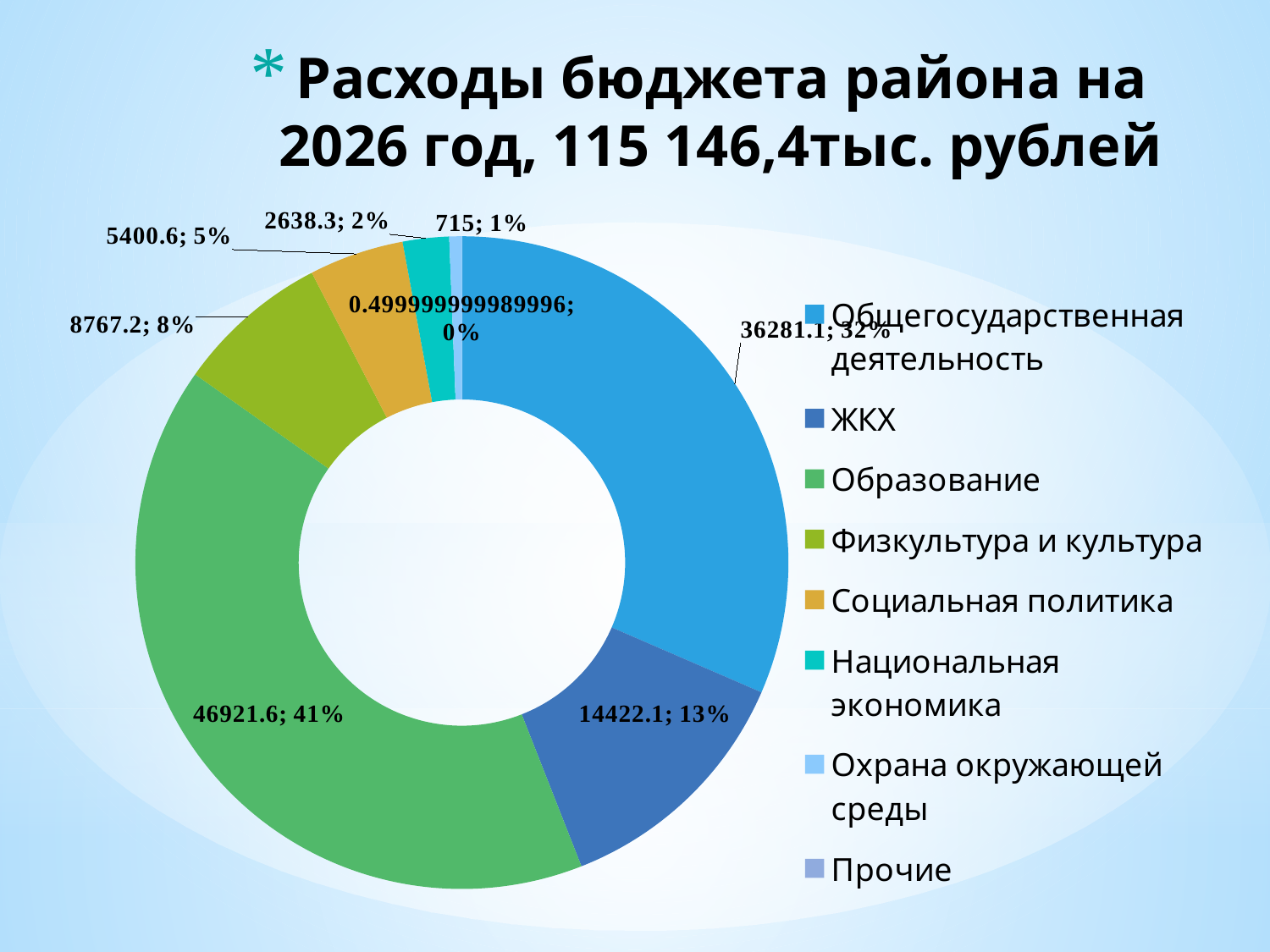
What value is shown for ЖКХ? 14422.1 What share of the chart does Общегосударственная деятельность take? 32% What value is shown for Охрана окружающей среды? 715 What is the title of the chart? Расходы бюджета района на 2026 год, 115 146,4тыс. рублей Which category has the largest slice? Образование What kind of chart is shown on the slide? doughnut (pie) chart What percentage is shown for Физкультура и культура? 8% Which category has the smallest slice? Прочие How many categories does the legend of the chart list? 8 What value is shown for Образование? 46921.6 Which is larger, the value for Социальная политика or the value for Национальная экономика? Социальная политика What is the difference between the values for Образование and Общегосударственная деятельность? 10640.5